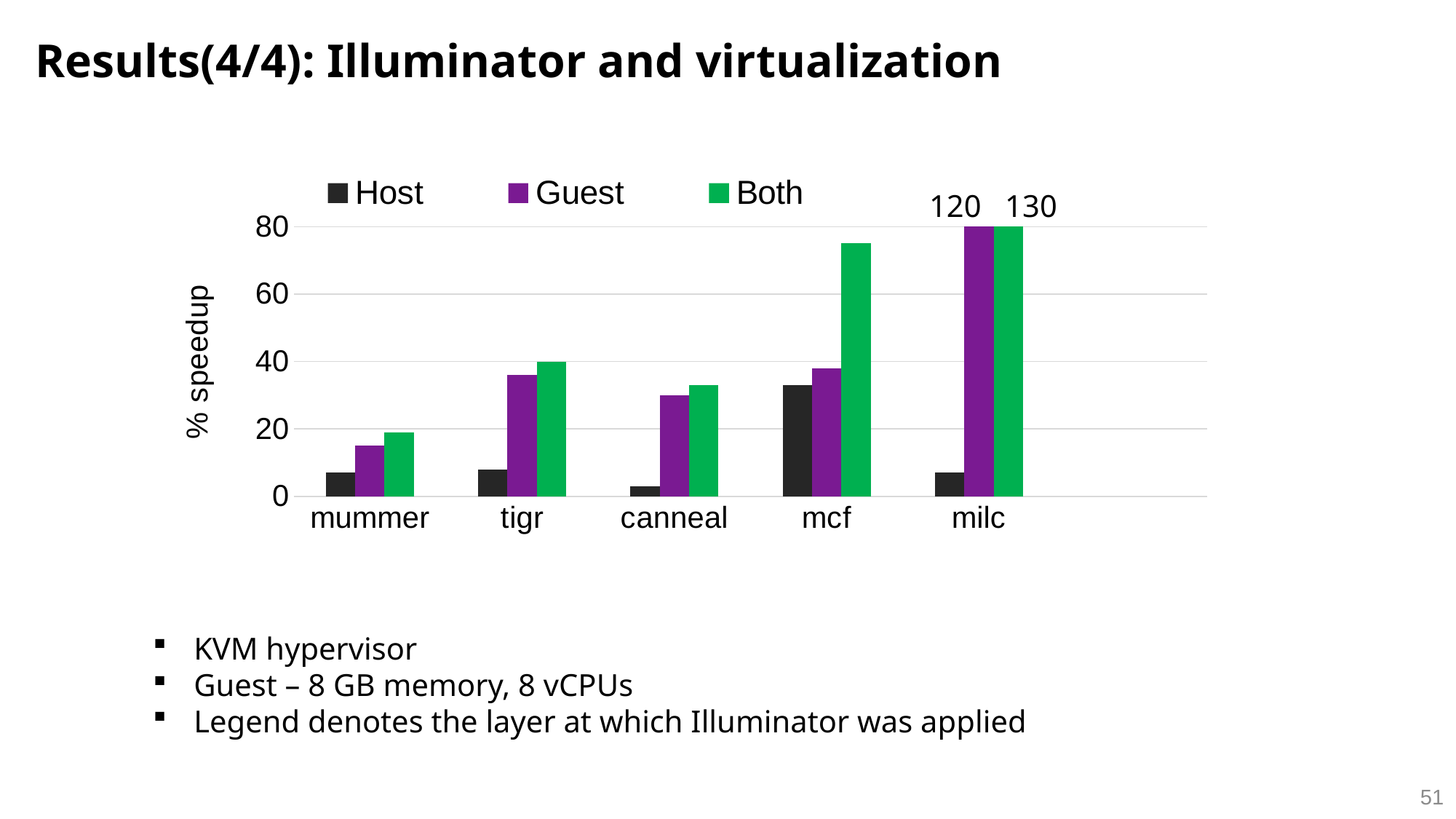
What is the % speedup for the Both series on milc? 130 Which benchmark has the highest % speedup for the Both series? milc How many series does the legend list? 3 For mcf, which is larger: the Guest value or the Both value? Both What is the difference between the Both and Guest values for milc? 10 What is the label on the y axis? % speedup What is the % speedup for the Guest series on milc? 120 What kind of chart is shown on the slide? bar chart Is the Both value for mcf greater or less than 60? greater Is the Host value for mcf greater or less than 40? less Which benchmark has the lowest Host % speedup? canneal How many benchmark categories are shown on the x axis? 5